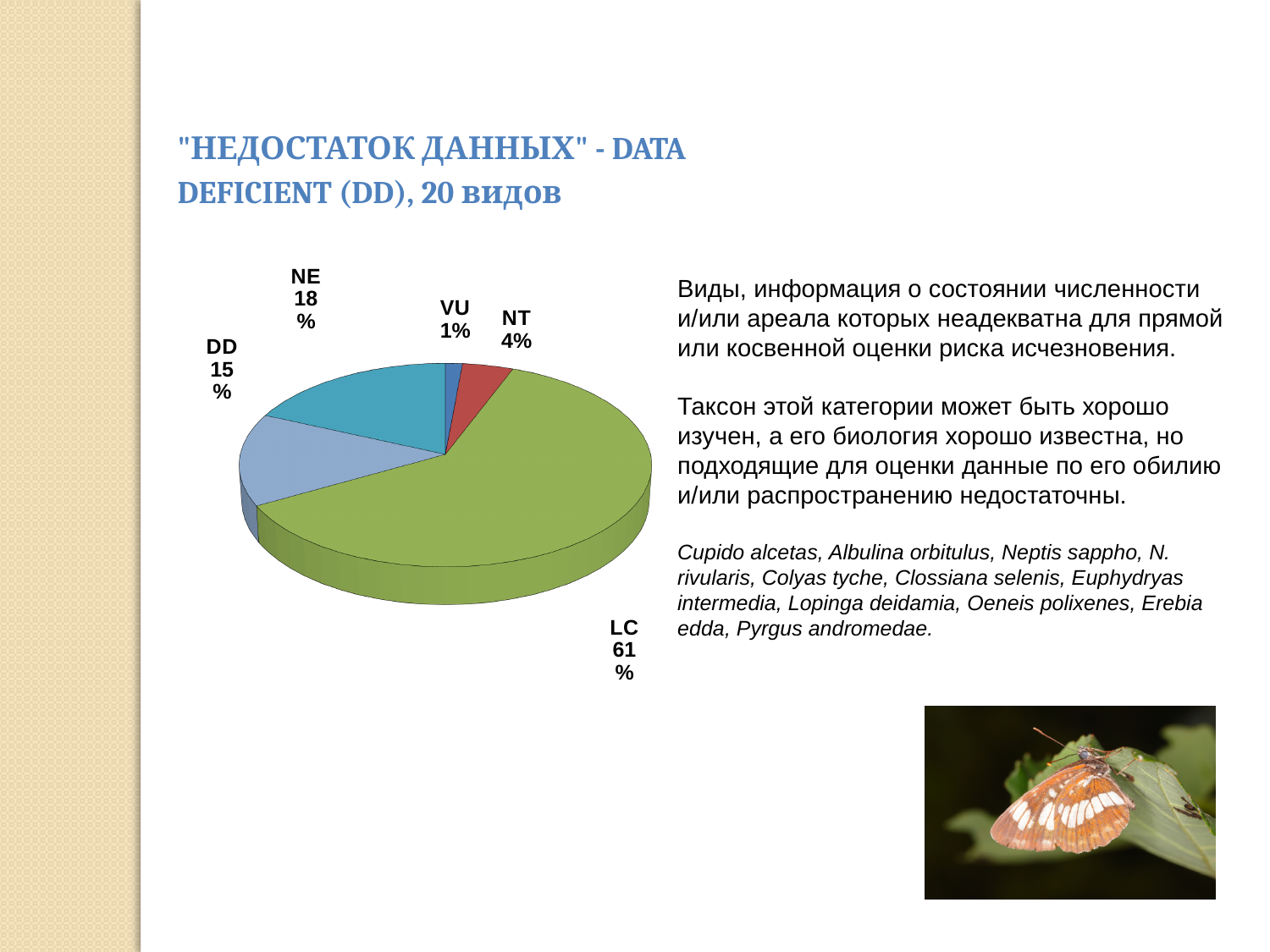
What kind of chart is shown on the slide? pie chart What share of the pie does the LC slice represent? 61% Which category has the smallest slice of the pie? VU What percentage is shown for the DD slice? 15% What colour is the LC slice of the pie chart? green Which slice is larger, NT or DD? DD What percentage is shown for the NE slice? 18% Which category has the largest slice of the pie? LC What percentage is shown for the VU slice? 1% How many slices does the pie chart have? 5 What percentage is shown for the NT slice? 4% What is the difference in percentage points between the NE and DD slices? 3